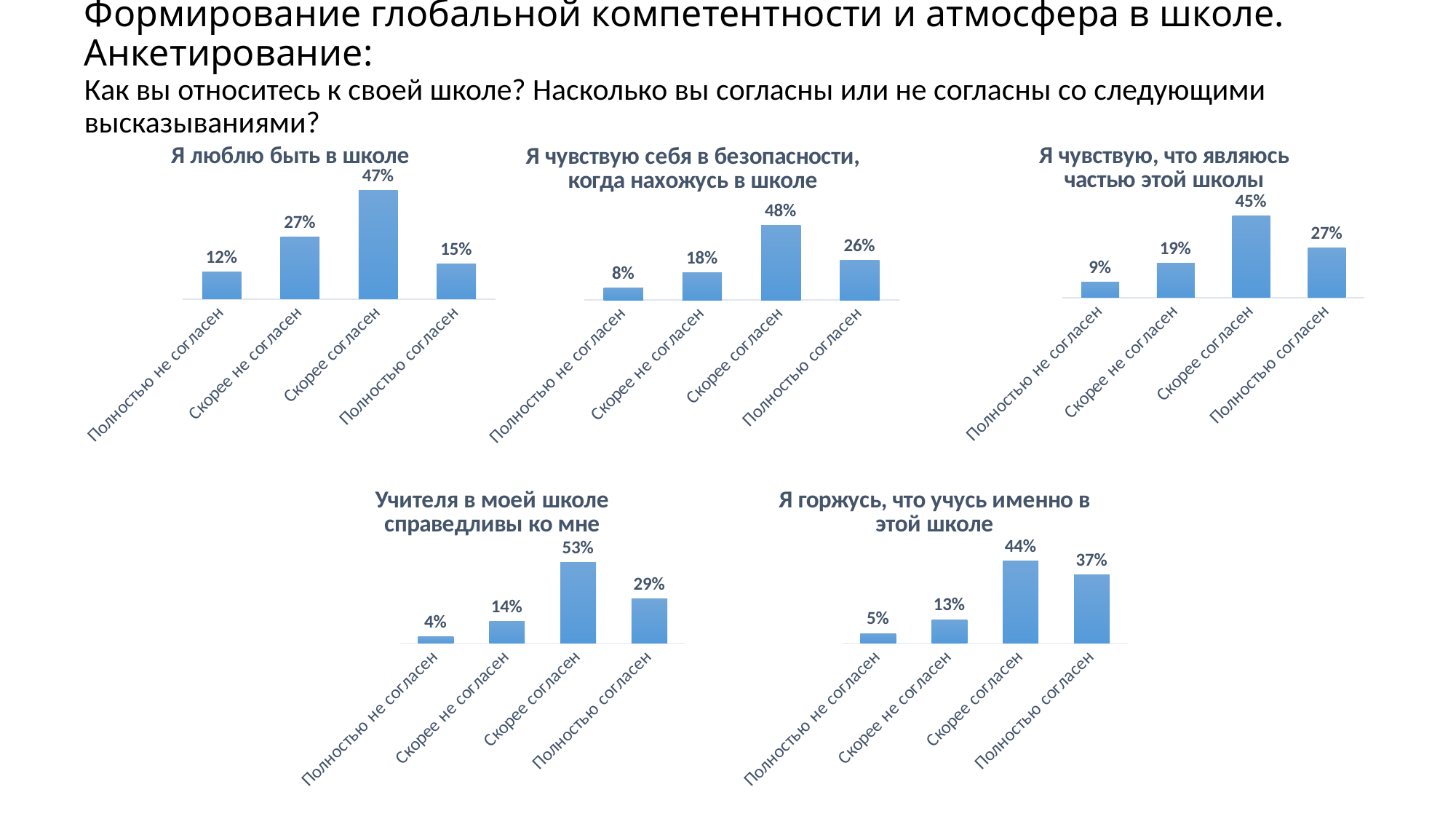
In the chart titled "Я чувствую, что являюсь частью этой школы", what is the value for "Полностью согласен"? 27% In the chart titled "Я чувствую, что являюсь частью этой школы", which category has the highest value? Скорее согласен In the chart titled "Учителя в моей школе справедливы ко мне", what is the difference between "Скорее согласен" and "Полностью согласен"? 24% In the chart titled "Я люблю быть в школе", which is larger: "Скорее не согласен" or "Полностью согласен"? Скорее не согласен What kind of chart is the one titled "Учителя в моей школе справедливы ко мне"? Bar chart How many charts are shown on the slide? 5 In the chart titled "Я горжусь, что учусь именно в этой школе", what is the difference between "Скорее согласен" and "Полностью согласен"? 7% In the chart titled "Учителя в моей школе справедливы ко мне", which category has the lowest value? Полностью не согласен In the chart titled "Я люблю быть в школе", what is the value for "Скорее согласен"? 47% In the chart titled "Я чувствую себя в безопасности, когда нахожусь в школе", what is the value for "Полностью не согласен"? 8% In the chart titled "Я горжусь, что учусь именно в этой школе", what is the value for "Скорее не согласен"? 13% How many categories are shown in the chart titled "Я чувствую себя в безопасности, когда нахожусь в школе"? 4